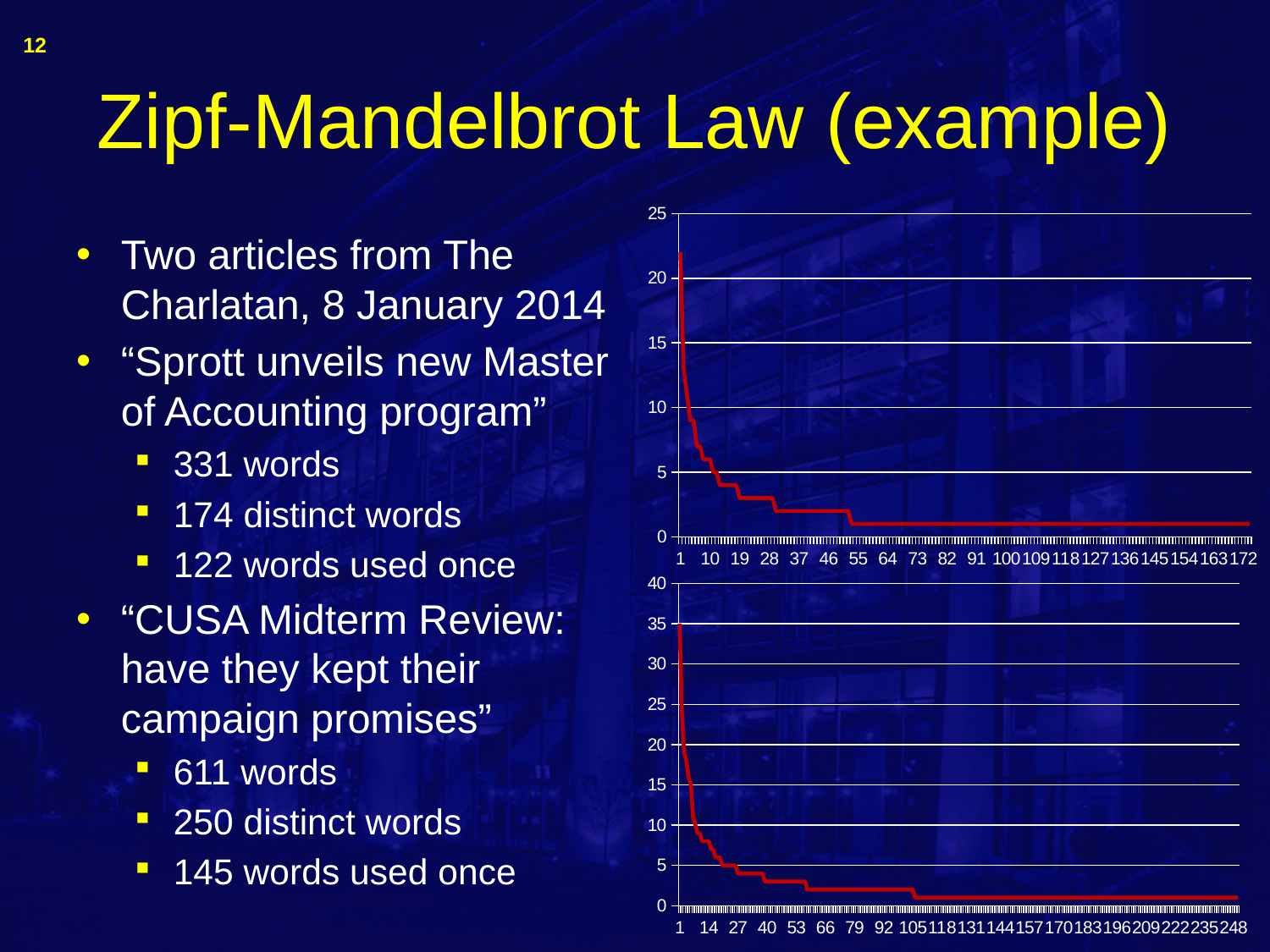
What colour is the line plotted in the top chart? red In the bottom chart, is the value at x = 14 greater or less than 15? less In the top chart, do the values rise or fall as you move along the x axis? fall In the top chart, is the value at x = 172 greater or less than 5? less In the bottom chart, is the value at x = 248 greater or less than 5? less What kind of chart is the top chart on the right of the slide? line chart What kind of chart is the bottom chart on the right of the slide? line chart In the bottom chart, do the values rise or fall as you move along the x axis? fall What is the highest value shown on the y axis of the bottom chart? 40